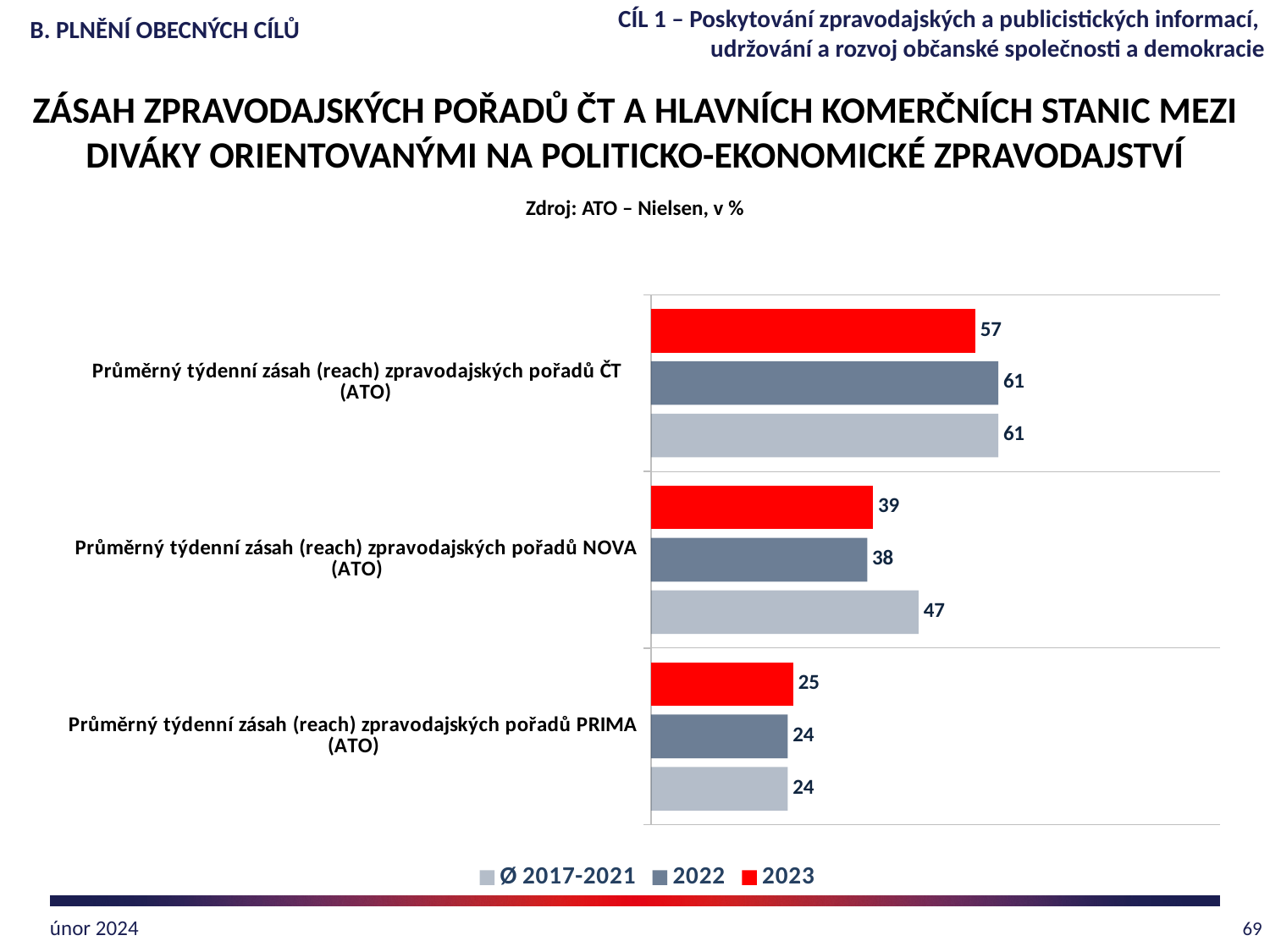
Which category has the highest 2023 value? Průměrný týdenní zásah (reach) zpravodajských pořadů ČT (ATO) What is the Ø 2017-2021 value for Průměrný týdenní zásah (reach) zpravodajských pořadů PRIMA (ATO)? 24 How many series does the legend list? 3 What is the 2023 value for Průměrný týdenní zásah (reach) zpravodajských pořadů ČT (ATO)? 57 What is the difference between the Ø 2017-2021 value and the 2023 value for Průměrný týdenní zásah (reach) zpravodajských pořadů NOVA (ATO)? 8 Which is larger for Průměrný týdenní zásah (reach) zpravodajských pořadů NOVA (ATO): the 2022 value or the 2023 value? 2023 What is the 2022 value for Průměrný týdenní zásah (reach) zpravodajských pořadů NOVA (ATO)? 38 Which category has the lowest Ø 2017-2021 value? Průměrný týdenní zásah (reach) zpravodajských pořadů PRIMA (ATO) What kind of chart is shown on the slide? Bar chart What is the difference between the 2022 and 2023 values for Průměrný týdenní zásah (reach) zpravodajských pořadů ČT (ATO)? 4 Which colour represents the 2023 series in the legend? Red How many categories are shown on the chart? 3